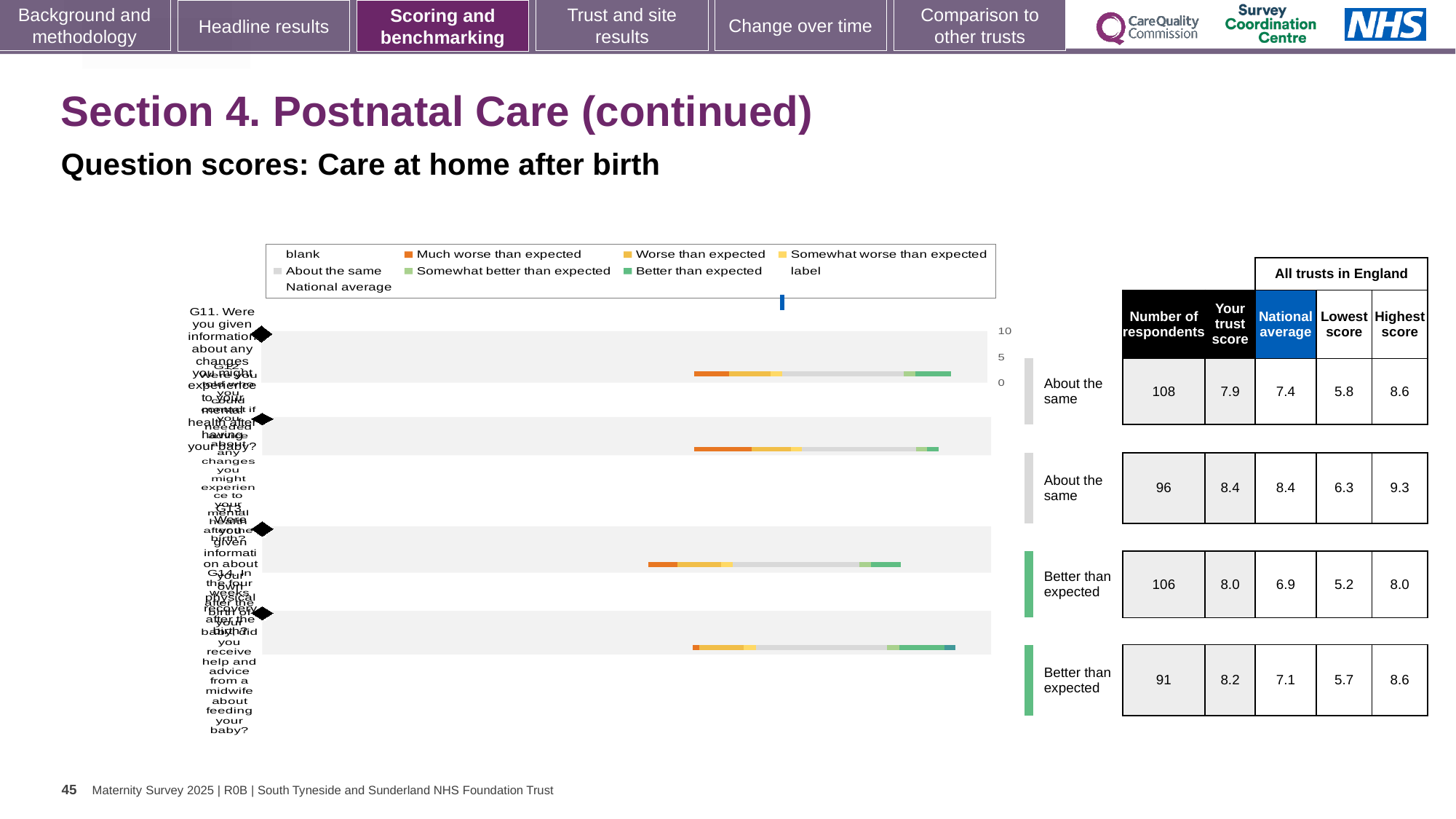
In the table beside the chart, what is the difference between 'Your trust score' and the 'National average' for the first (top) row? 0.5 In the table beside the chart, what is 'Your trust score' for the first (top) question row? 7.9 In the chart legend, what colour represents 'Better than expected'? green How many of the four question rows are rated 'Better than expected'? 2 In the chart legend, what colour represents 'Much worse than expected'? orange How many horizontal bars are plotted in the chart? 4 What kind of chart is shown on the slide? bar chart In the table beside the chart, which row has the lowest value in the 'Lowest score' column? the third row (5.2) In the table beside the chart, which row has the highest 'Your trust score'? the second row (8.4) In the table beside the chart, what is the 'Highest score' for the fourth (bottom) row? 8.6 In the table beside the chart, what is the number of respondents for the first (top) question row? 108 In the table beside the chart, for the third row, which is larger: 'Your trust score' or the 'National average'? Your trust score (8.0)